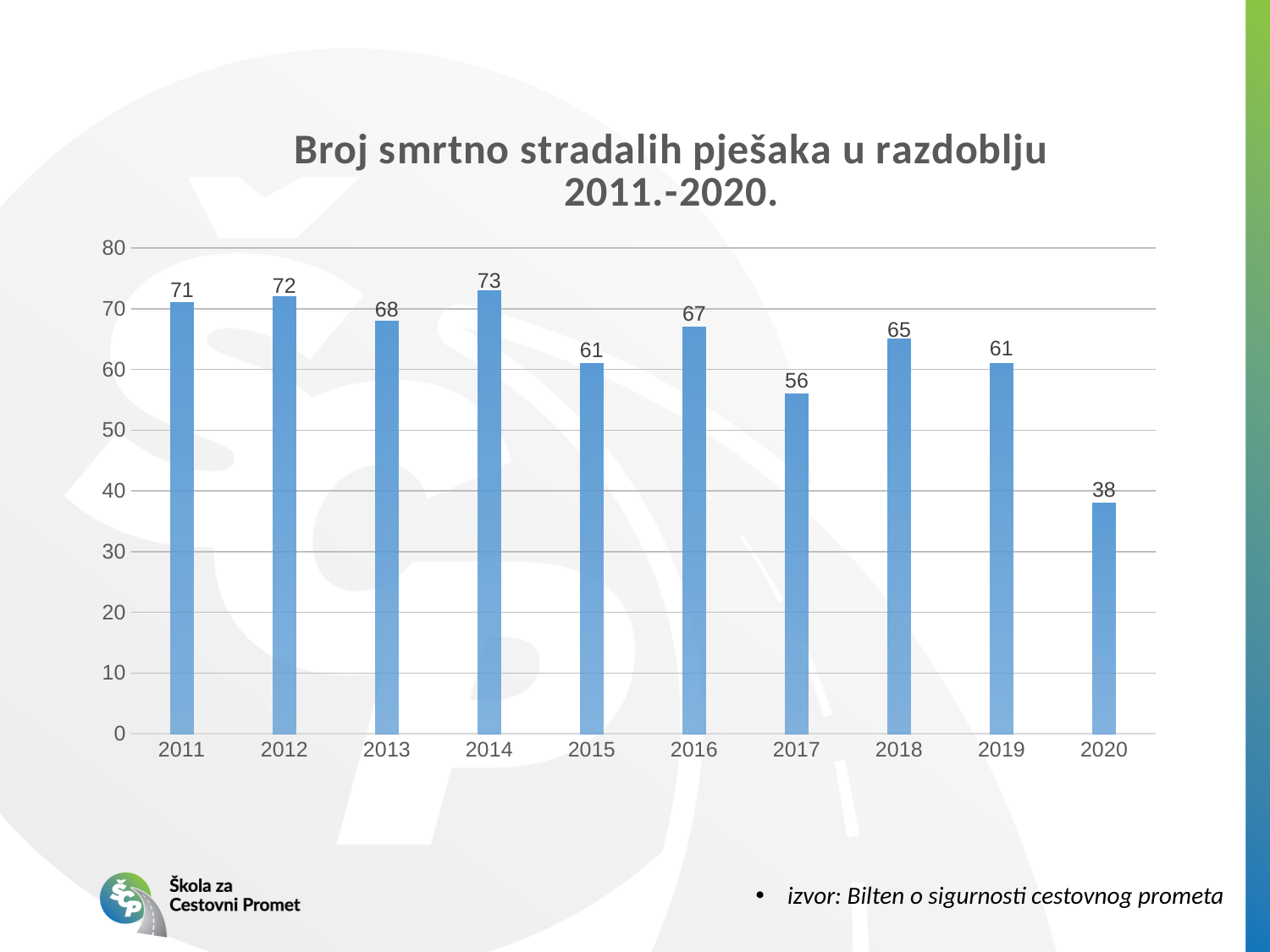
How many years are shown on the x axis? 10 Which year has the lowest value? 2020 What is the value for 2020? 38 Is the value for 2012 greater or less than 70? greater What is the title of the chart? Broj smrtno stradalih pješaka u razdoblju 2011.-2020. What kind of chart is shown on the slide? bar chart What is the value for 2017? 56 Do the values rise or fall from 2018 to 2020? fall Which year has the highest value? 2014 What is the value for 2014? 73 Which is larger, the value for 2016 or the value for 2018? 2016 What is the difference between the values for 2019 and 2020? 23